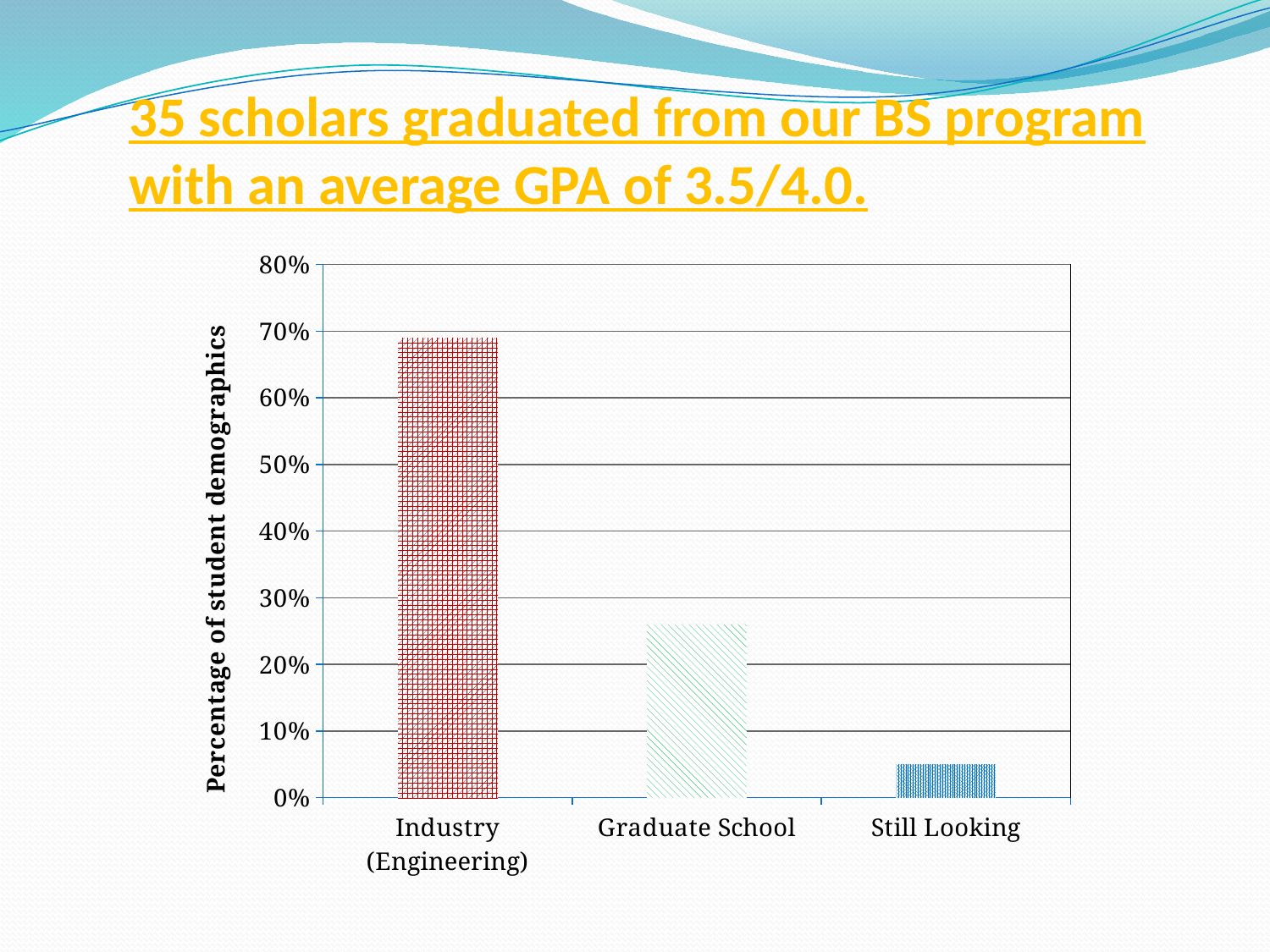
Which is larger, the value for Industry (Engineering) or the value for Graduate School? Industry (Engineering) Which category has the lowest value in the chart? Still Looking What kind of chart is shown on the slide? bar chart Which is larger, the value for Graduate School or the value for Still Looking? Graduate School What is the highest value shown on the vertical axis of the chart? 80% Is the value for Still Looking greater or less than 10%? less How many categories are plotted on the x axis of the chart? 3 Is the value for Graduate School greater or less than 30%? less Is the value for Industry (Engineering) greater or less than 60%? greater Which category has the highest value in the chart? Industry (Engineering) Do the bar values rise or fall moving from left to right along the x axis? fall What is the title of the vertical axis of the chart? Percentage of student demographics